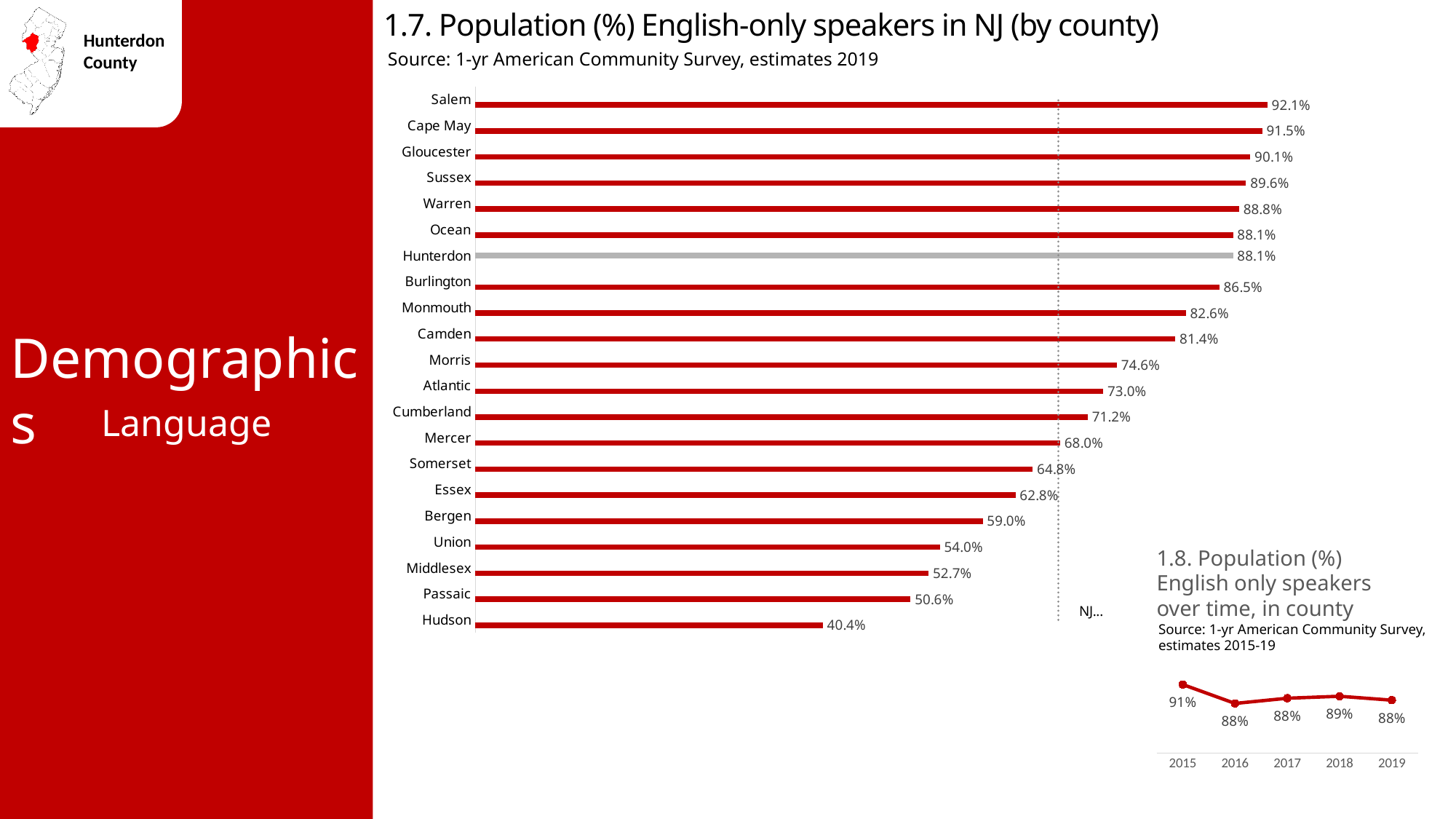
In the chart '1.7. Population (%) English-only speakers in NJ (by county)', which county's bar is coloured grey instead of red? Hunterdon In the chart '1.7. Population (%) English-only speakers in NJ (by county)', which county has the highest value? Salem In the chart '1.8. Population (%) English only speakers over time, in county', what is the value for 2018? 89% What kind of chart is '1.8. Population (%) English only speakers over time, in county'? Line chart In the chart '1.7. Population (%) English-only speakers in NJ (by county)', what is the value for Morris? 74.6% In the chart '1.7. Population (%) English-only speakers in NJ (by county)', which has a larger value, Bergen or Mercer? Mercer In the chart '1.7. Population (%) English-only speakers in NJ (by county)', what is the difference between the values for Salem and Hudson? 51.7% In the chart '1.7. Population (%) English-only speakers in NJ (by county)', what is the value for Hunterdon? 88.1% In the chart '1.8. Population (%) English only speakers over time, in county', what is the value for 2015? 91% What kind of chart is '1.7. Population (%) English-only speakers in NJ (by county)'? Bar chart How many counties are shown in the chart '1.7. Population (%) English-only speakers in NJ (by county)'? 21 In the chart '1.7. Population (%) English-only speakers in NJ (by county)', which county has the lowest value? Hudson